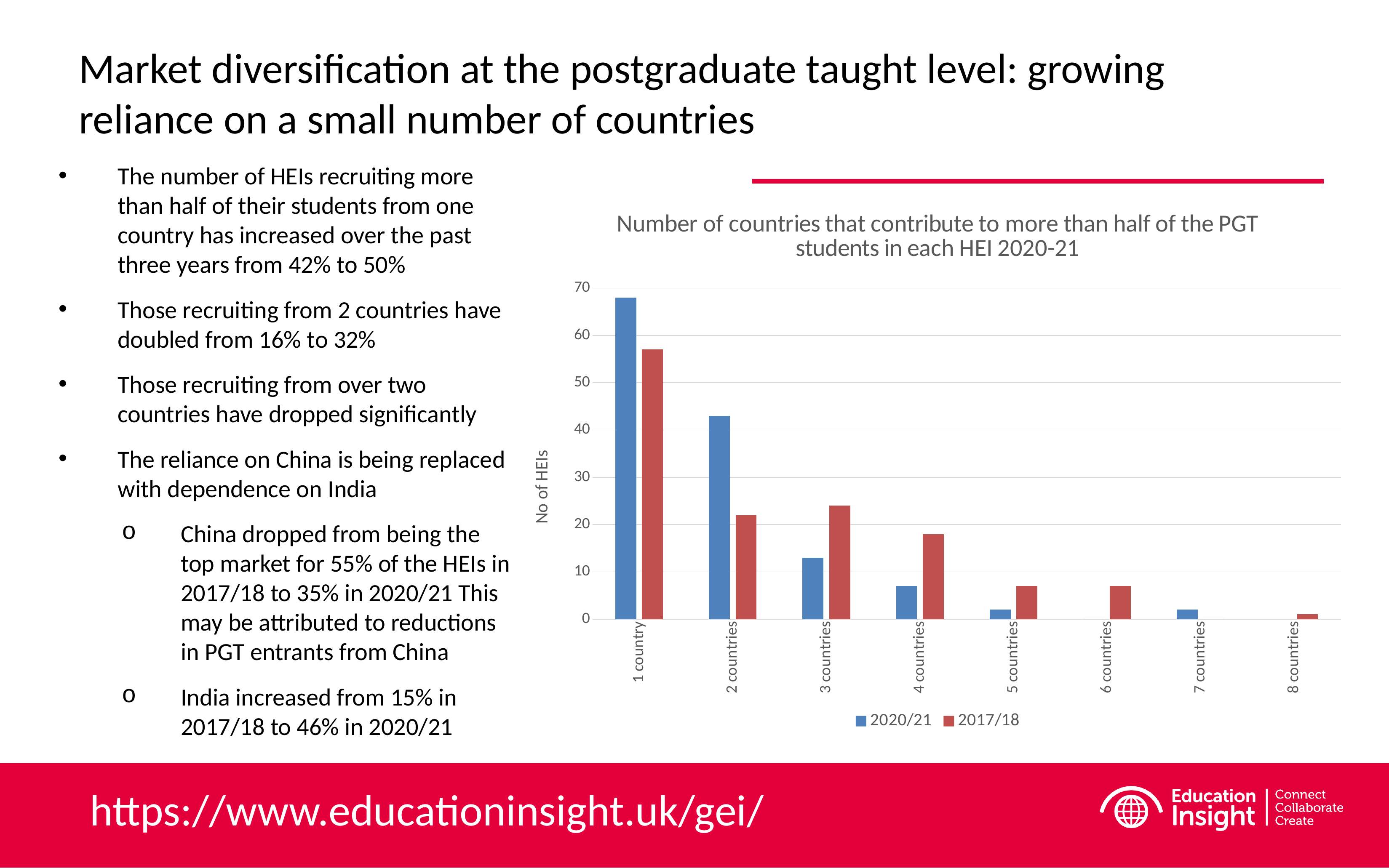
What is the title of the chart? Number of countries that contribute to more than half of the PGT students in each HEI 2020-21 What kind of chart is shown on the slide? Bar chart Which category has the highest value for the 2020/21 series? 1 country How many categories are shown on the x axis of the chart? 8 Do the 2020/21 values generally rise or fall moving from 1 country to 8 countries along the x axis? Fall Is the 2017/18 value for 1 country greater or less than 50? greater For 3 countries, which series has the larger value, 2020/21 or 2017/18? 2017/18 Which category has the highest value for the 2017/18 series? 1 country For 2 countries, which series has the larger value, 2020/21 or 2017/18? 2020/21 Is the 2020/21 value for 4 countries greater or less than 10? less Is the 2020/21 value for 1 country greater or less than 60? greater How many series does the chart legend list? 2